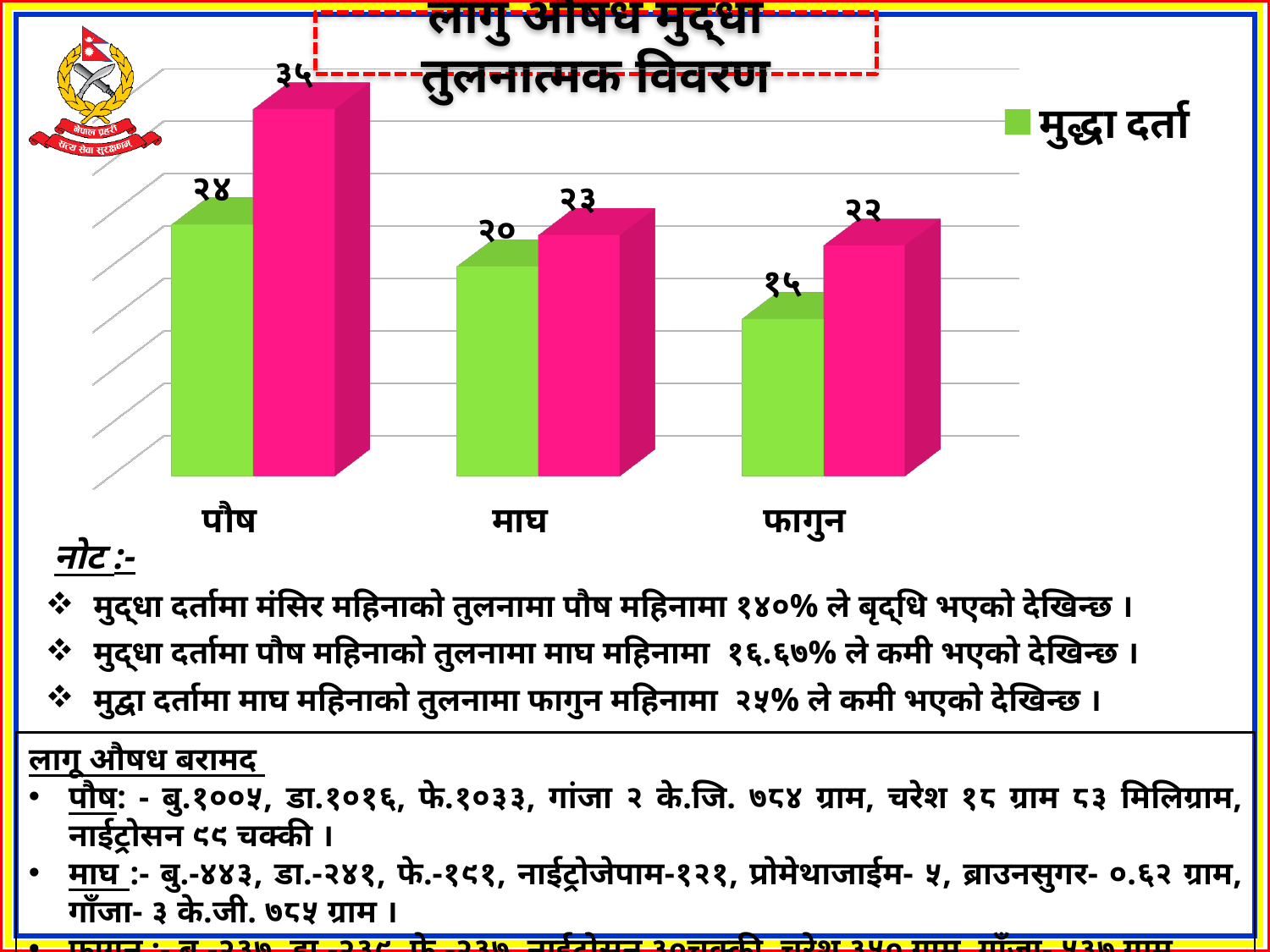
What series name is shown in the chart legend? मुद्धा दर्ता What is the difference between the pink bar and the green bar for पौष? ११ What is the value of the pink bar for फागुन? २२ Which is larger for माघ: the green bar or the pink bar? the pink bar What type of chart is shown on the slide? bar chart How many categories are shown on the x axis of the chart? 3 What is the value of the pink bar for पौष? ३५ Which category has the highest value for the pink series? पौष What is the value of the green (मुद्धा दर्ता) bar for पौष? २४ Which category has the lowest value for the green (मुद्धा दर्ता) series? फागुन What is the value of the green (मुद्धा दर्ता) bar for माघ? २० Do the values of the green (मुद्धा दर्ता) series rise or fall from पौष to फागुन? fall